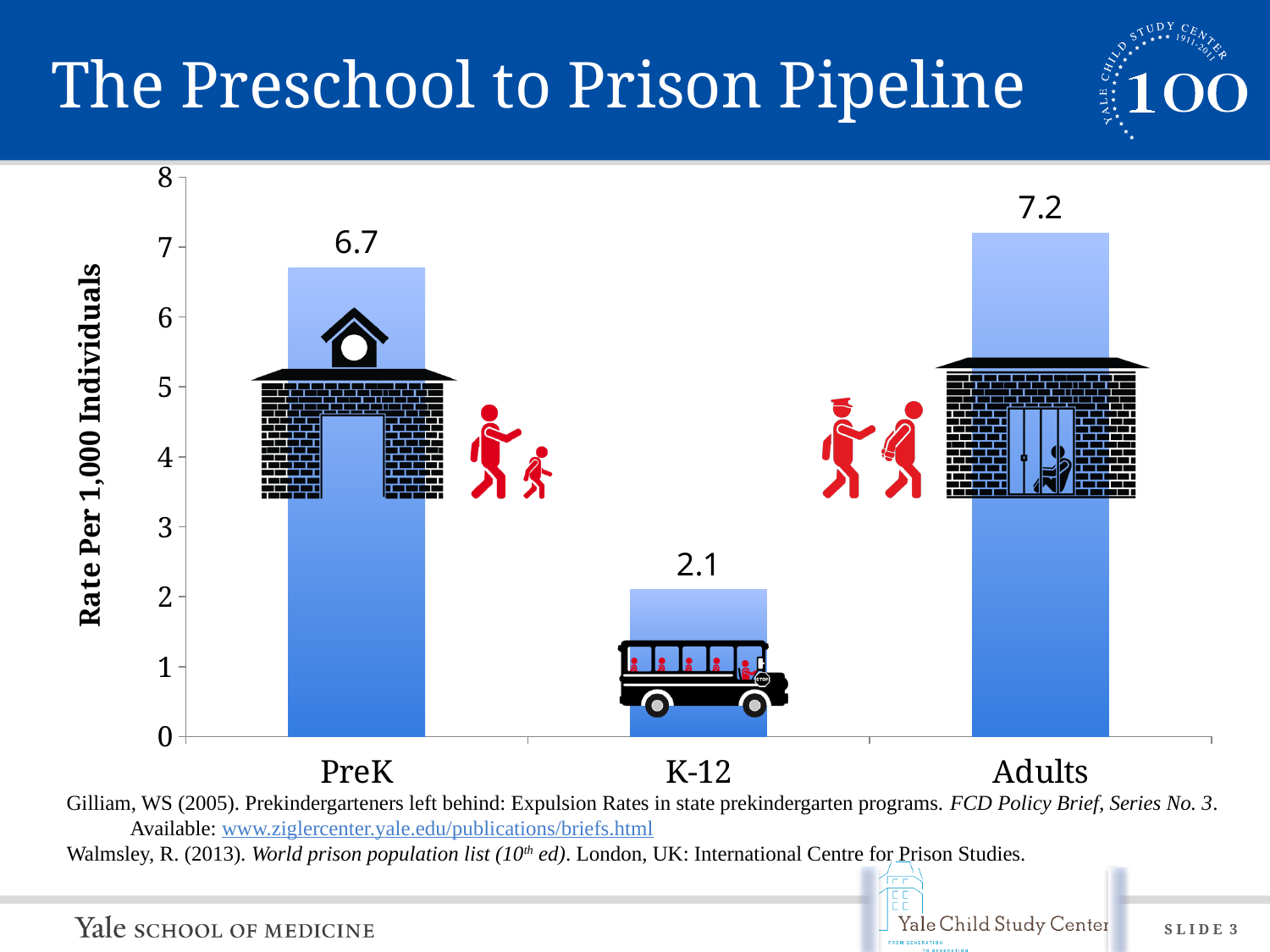
Which category has the highest rate per 1,000 individuals? Adults What is the difference between the PreK rate and the K-12 rate? 4.6 What is the rate per 1,000 individuals for PreK? 6.7 What is the difference between the Adults rate and the PreK rate? 0.5 Which has a higher rate per 1,000 individuals, PreK or K-12? PreK Is the value for K-12 greater or less than 3? less What kind of chart is shown on the slide? bar chart How many categories are shown on the x axis? 3 Which category has the lowest rate per 1,000 individuals? K-12 What is the rate per 1,000 individuals for Adults? 7.2 What is the rate per 1,000 individuals for K-12? 2.1 What is the label of the y axis? Rate Per 1,000 Individuals